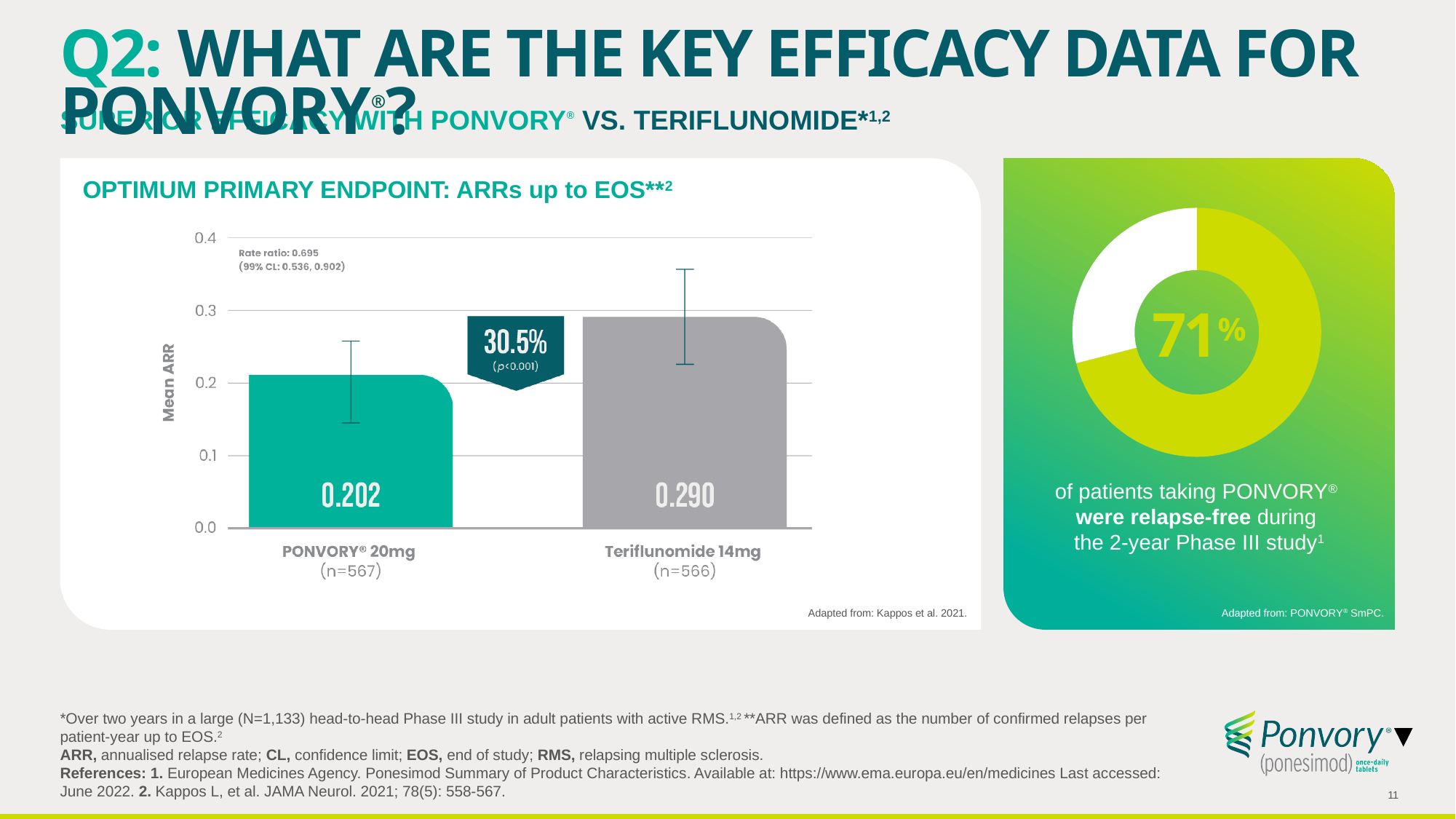
In the bar chart titled 'OPTIMUM PRIMARY ENDPOINT: ARRs up to EOS', what is the mean ARR for Teriflunomide 14mg? 0.290 In the bar chart titled 'OPTIMUM PRIMARY ENDPOINT: ARRs up to EOS', what is the mean ARR for PONVORY 20mg? 0.202 In the donut chart on the right, what percentage of patients taking PONVORY were relapse-free during the 2-year Phase III study? 71% In the bar chart on the left, what is the difference in mean ARR between Teriflunomide 14mg and PONVORY 20mg? 0.088 In the bar chart on the left, what is the number of patients (n) in the PONVORY 20mg group? n=567 In the bar chart on the left, which treatment has the higher mean ARR? Teriflunomide 14mg In the bar chart on the left, is the mean ARR for PONVORY 20mg greater or less than 0.3? less In the bar chart on the left, which treatment has the lower mean ARR? PONVORY 20mg In the bar chart on the left, what is the label of the y axis? Mean ARR What kind of chart is used to show the ARRs up to EOS on the left of the slide? bar chart In the bar chart on the left, what percentage reduction is shown in the label between the two bars? 30.5% In the bar chart on the left, how many treatment groups are plotted? 2